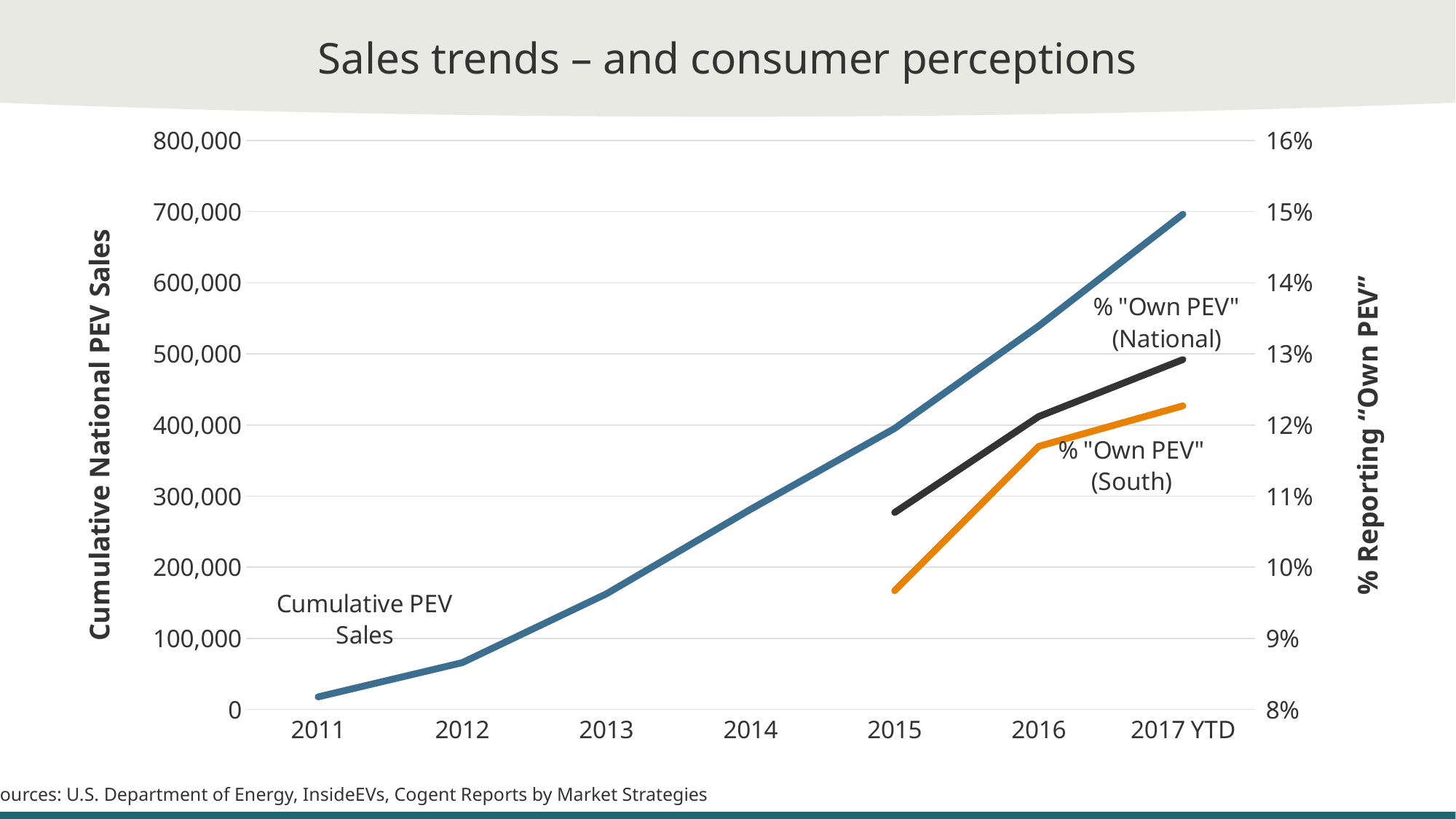
What is the label of the right-hand vertical axis? % Reporting "Own PEV" Is the Cumulative PEV Sales value for 2013 greater or less than 200,000? less In 2015, which is higher: % "Own PEV" (National) or % "Own PEV" (South)? % "Own PEV" (National) Is the Cumulative PEV Sales value for 2012 greater or less than 100,000? less How many data series are plotted on the chart? 3 Is the % "Own PEV" (National) value for 2017 YTD greater or less than 12%? greater How many years are shown along the x axis? 7 What kind of chart is shown on the slide? line chart What is the title of the slide's chart? Sales trends – and consumer perceptions Does the Cumulative PEV Sales line rise or fall from 2011 to 2017 YTD? rise